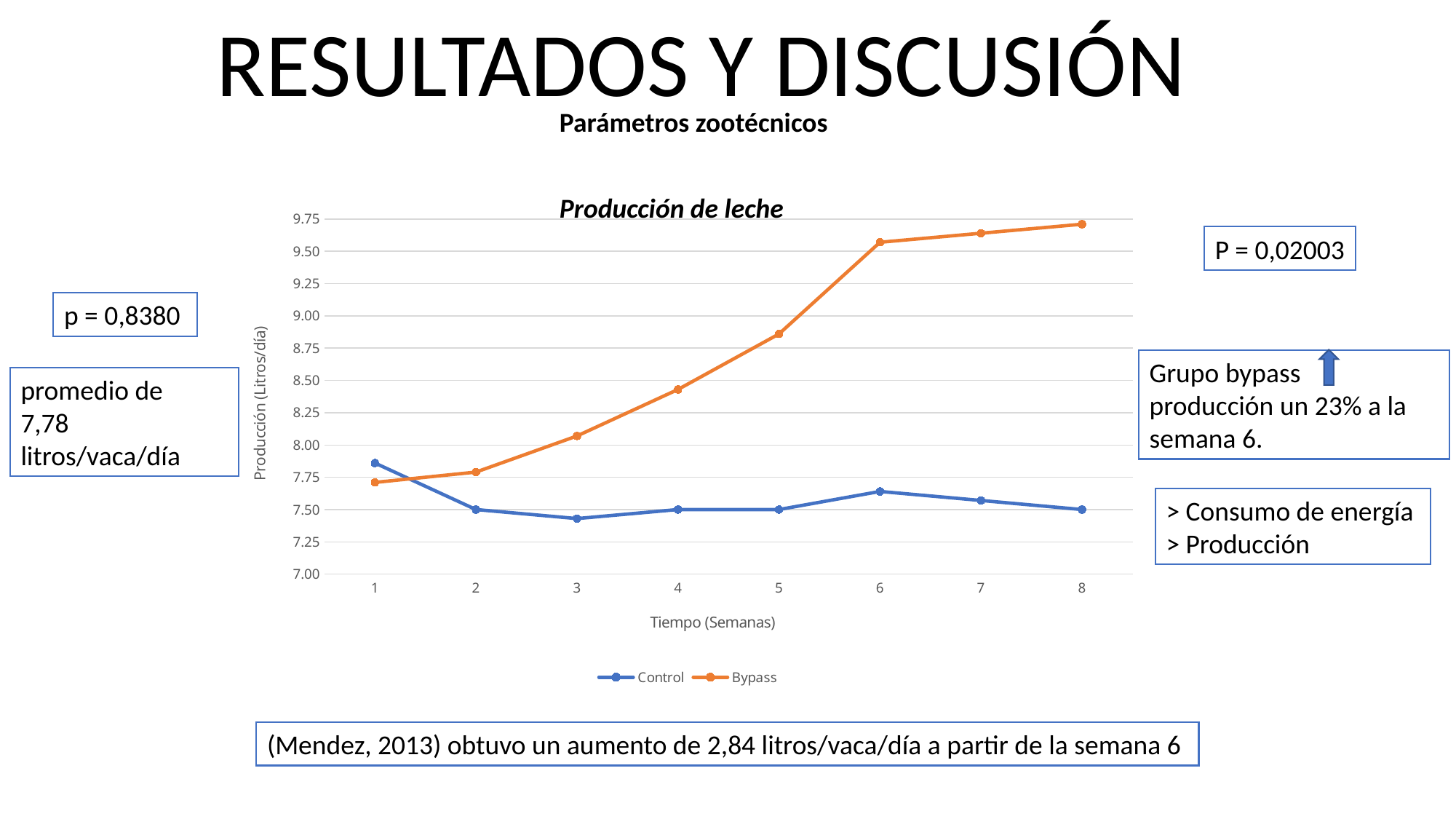
How many weeks (points) are plotted along the x axis of the chart? 8 Is the value for Control in week 3 greater or less than 7.50? less In which week does the Control series reach its lowest value? 3 How many series does the legend of the 'Producción de leche' chart list? 2 In week 6, which series has the higher value, Control or Bypass? Bypass In week 1, which series has the higher value, Control or Bypass? Control What is the title of the chart? Producción de leche Is the value for Bypass in week 4 greater or less than 8.25? greater In which week does the Bypass series reach its highest value? 8 What kind of chart is shown on the slide? line chart Is the value for Bypass in week 6 greater or less than 9.25? greater Does the Bypass series rise or fall from week 1 to week 8? rise